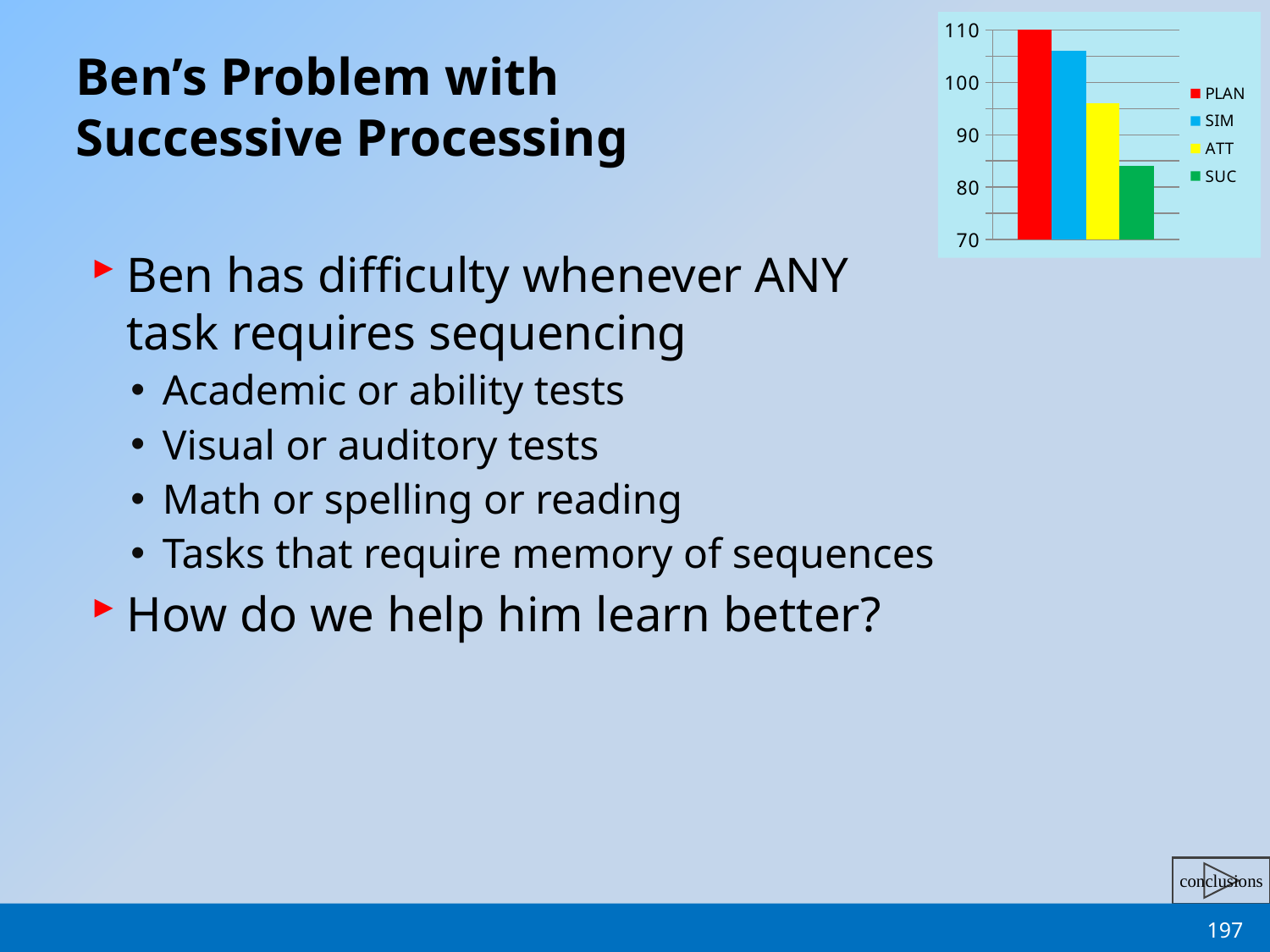
Do the bar values rise or fall from left to right across the chart? fall Which series has the lowest bar in the chart? SUC What kind of chart is shown on the slide? bar chart Which series has the highest bar in the chart? PLAN Which is larger in the chart, the value for ATT or the value for SUC? ATT Is the value for ATT greater or less than 90? greater Is the value for SIM greater or less than 100? greater How many bars are plotted in the chart? 4 How many series does the chart legend list? 4 Is the value for SUC greater or less than 90? less Which is larger in the chart, the value for SIM or the value for ATT? SIM What colour is the bar for SUC in the chart? green